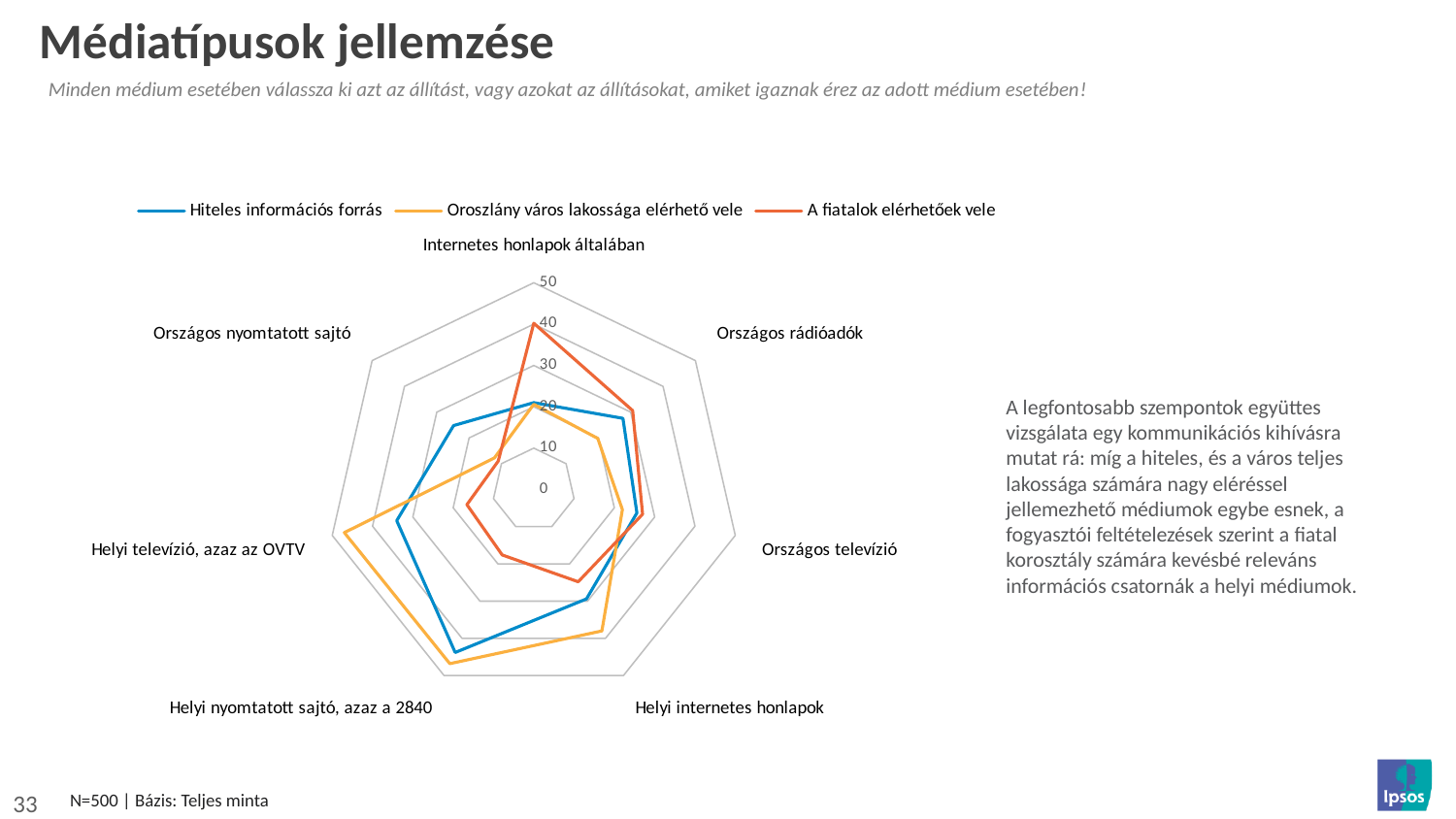
What kind of chart is shown on the slide? Radar chart How many media categories (axes) does the radar chart have? 7 Is the value of 'Oroszlány város lakossága elérhető vele' for 'Helyi televízió, azaz az OVTV' greater or less than 40? greater For 'Internetes honlapok általában', which series has the larger value: 'Hiteles információs forrás' or 'A fiatalok elérhetőek vele'? A fiatalok elérhetőek vele Is the value of 'A fiatalok elérhetőek vele' for 'Országos nyomtatott sajtó' greater or less than 20? less How many series does the legend list? 3 Which series is drawn in blue? Hiteles információs forrás For the series 'A fiatalok elérhetőek vele', which category has the highest value? Internetes honlapok általában For 'Helyi nyomtatott sajtó, azaz a 2840', which series has the larger value: 'Oroszlány város lakossága elérhető vele' or 'A fiatalok elérhetőek vele'? Oroszlány város lakossága elérhető vele Is the value of 'A fiatalok elérhetőek vele' for 'Internetes honlapok általában' greater or less than 30? greater What is the highest value shown on the radar chart's axis scale? 50